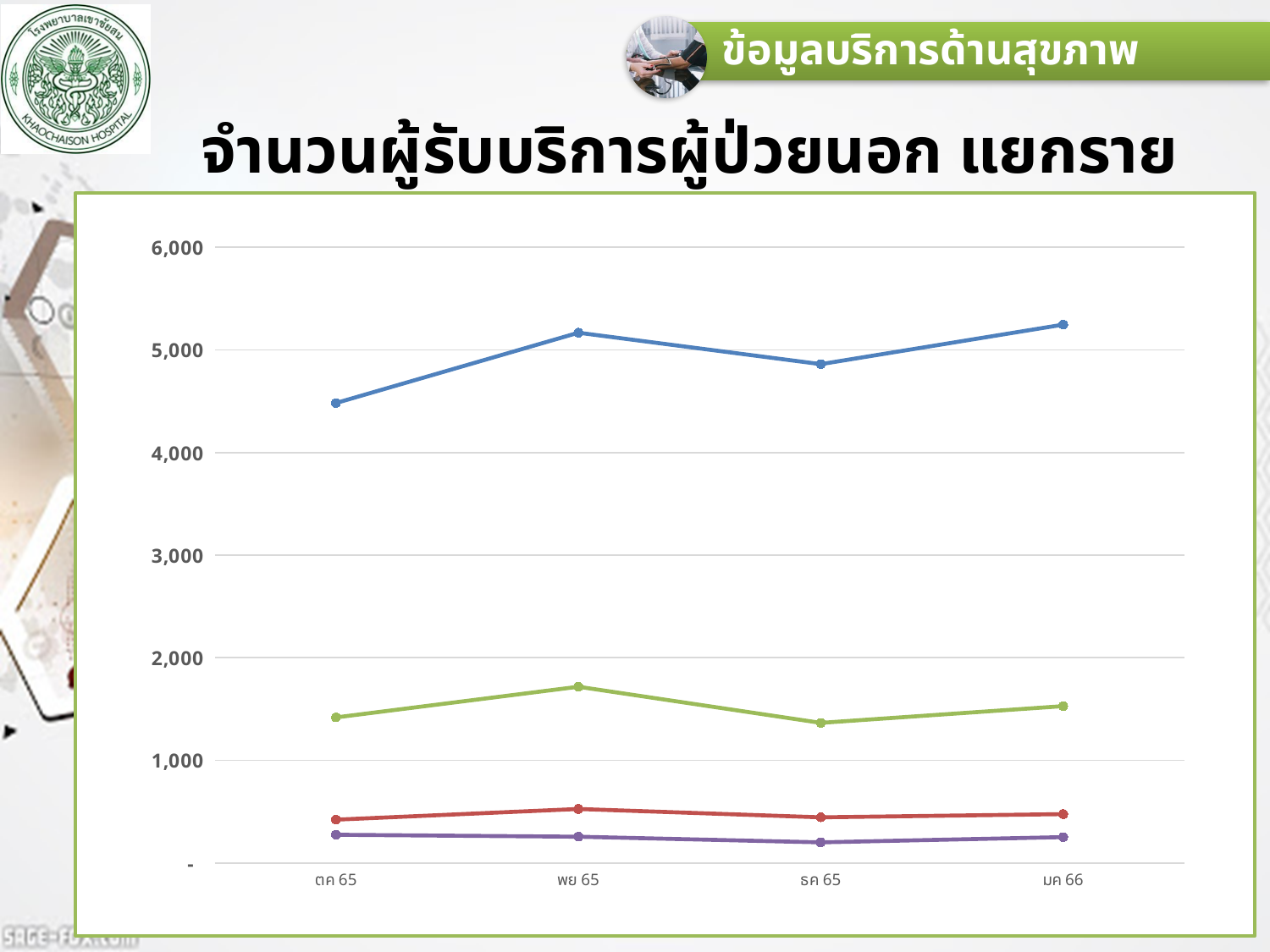
At which category does the green line reach its highest value? พย 65 At which category does the blue line have its lowest value? ตค 65 Is the value of the green line at ธค 65 greater or less than 1,000? greater Is the value of the blue line at พย 65 greater or less than 5,000? greater What kind of chart is shown on the slide? line chart At which category does the purple line have its lowest value? ธค 65 How many lines are plotted on the chart? 4 How many categories are shown on the x axis of the chart? 4 For the blue line, which is larger: the value at พย 65 or the value at ธค 65? พย 65 Is the value of the green line at พย 65 greater or less than 2,000? less Does the blue line rise or fall from ธค 65 to มค 66? rise